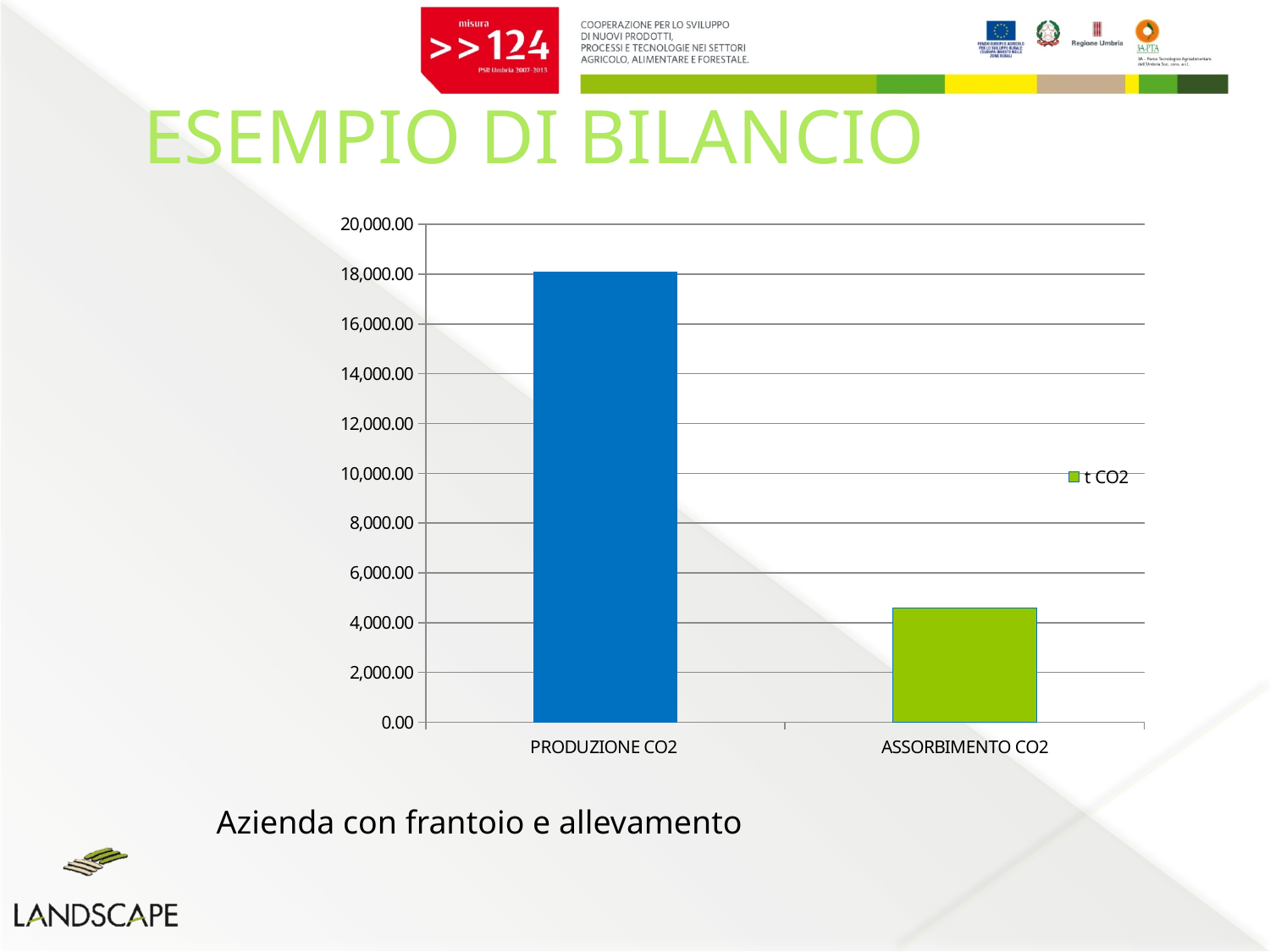
Is the value for ASSORBIMENTO CO2 greater or less than 6,000.00? less Which is larger, the value for PRODUZIONE CO2 or the value for ASSORBIMENTO CO2? PRODUZIONE CO2 Which category has the lowest value in the chart? ASSORBIMENTO CO2 Do the values rise or fall from left to right along the x axis? fall How many categories are plotted on the x axis of the chart? 2 What is the name of the series shown in the chart legend? t CO2 What kind of chart is shown on the slide? bar chart Which category has the highest value in the chart? PRODUZIONE CO2 Is the value for PRODUZIONE CO2 greater or less than 16,000.00? greater How many series does the chart legend list? 1 What is the highest value shown on the chart's vertical axis? 20,000.00 Is the value for ASSORBIMENTO CO2 greater or less than 4,000.00? greater